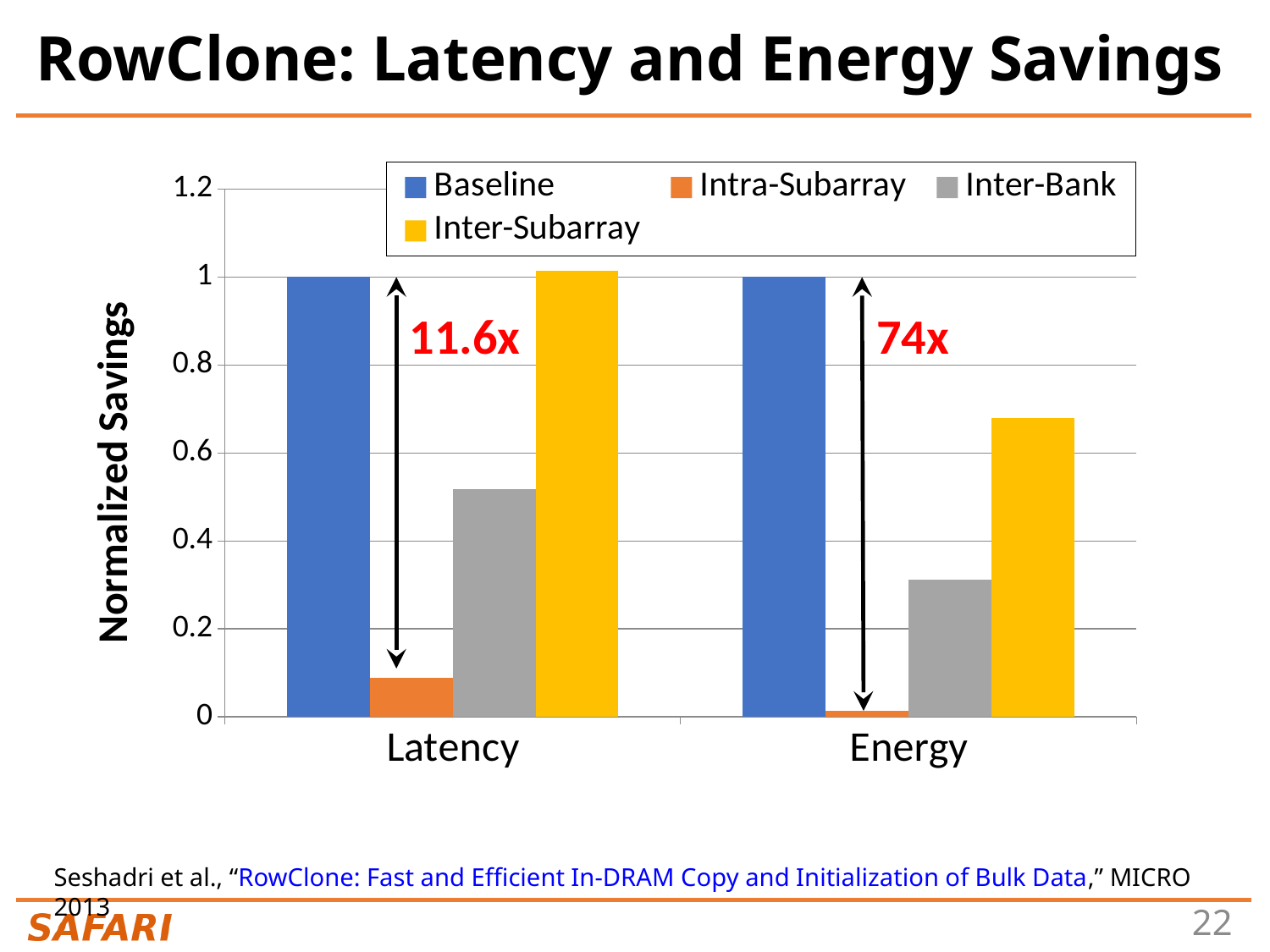
Is the Inter-Subarray value for Energy greater or less than 0.6? greater What is the Baseline value for Latency? 1 Is the Inter-Bank value for Latency greater or less than 0.4? greater How many categories are shown on the x axis? 2 Is the Inter-Bank value for Energy greater or less than 0.4? less What kind of chart is shown on the slide? bar chart How many series does the legend list? 4 Is the Inter-Bank value larger for Latency or for Energy? Latency What improvement factor is annotated above the Energy bars? 74x What is the Baseline value for Energy? 1 Which series has the lowest value for Energy? Intra-Subarray